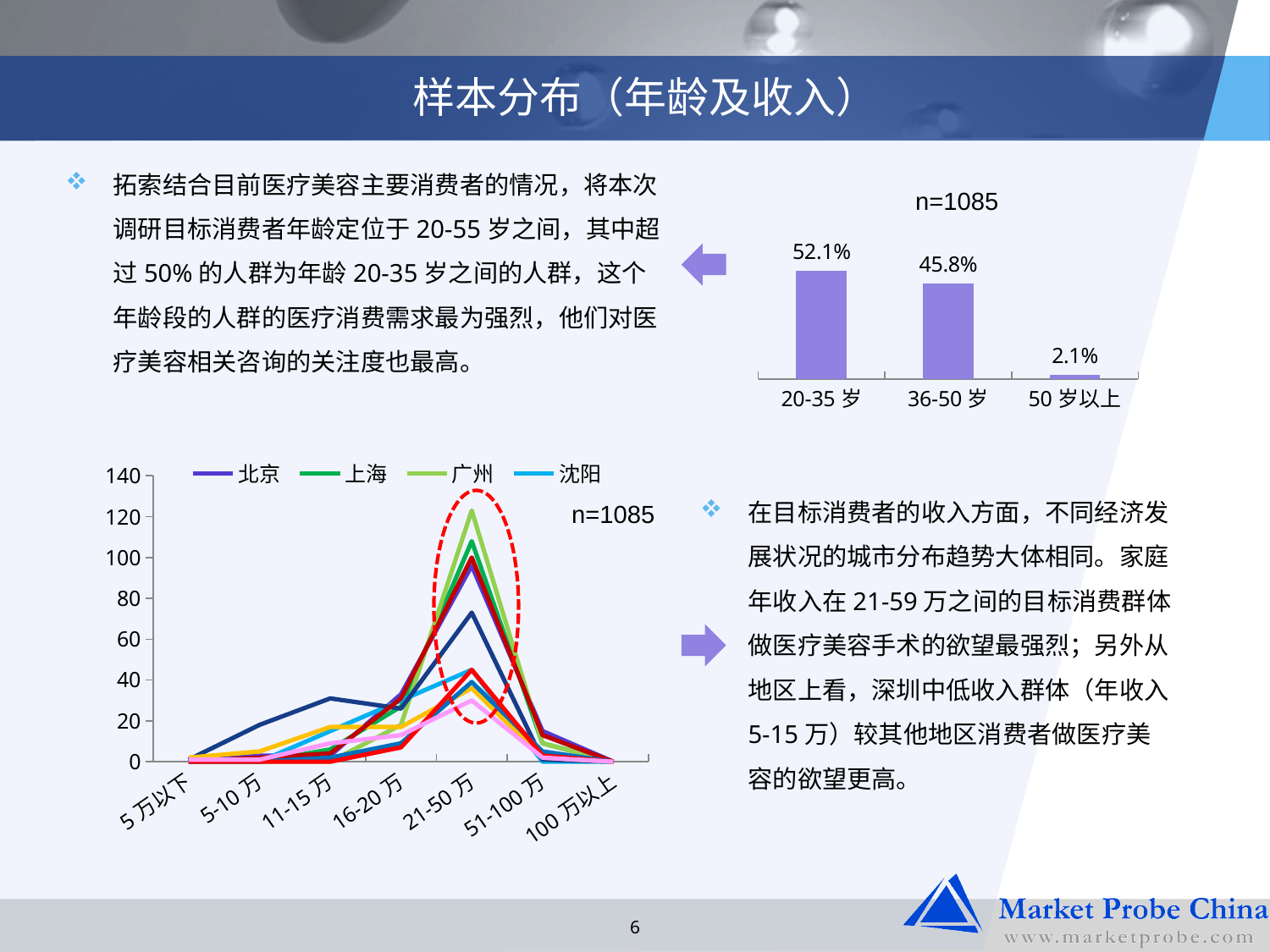
In the age distribution bar chart at the top right, which age group has the largest share? 20-35 岁 In the age distribution bar chart at the top right, what percentage of the sample is 50 岁以上? 2.1% In the age distribution bar chart at the top right, which age group has the smallest share? 50 岁以上 In the age distribution bar chart at the top right, what percentage of the sample is aged 36-50 岁? 45.8% In the age distribution bar chart at the top right, what percentage of the sample is aged 20-35 岁? 52.1% What kind of chart is the age distribution chart at the top right? bar chart What kind of chart is the income distribution chart at the bottom left? line chart In the income line chart at the bottom left, how many income categories are shown on the x axis? 7 In the income line chart at the bottom left, is the peak value of the 广州 line at 21-50 万 greater or less than 100? greater In the age distribution bar chart at the top right, what is the difference in percentage points between the 20-35 岁 and 36-50 岁 groups? 6.3 In the age distribution bar chart at the top right, how many age groups are shown? 3 In the income line chart at the bottom left, is the value of the 沈阳 line at 21-50 万 greater or less than 60? less